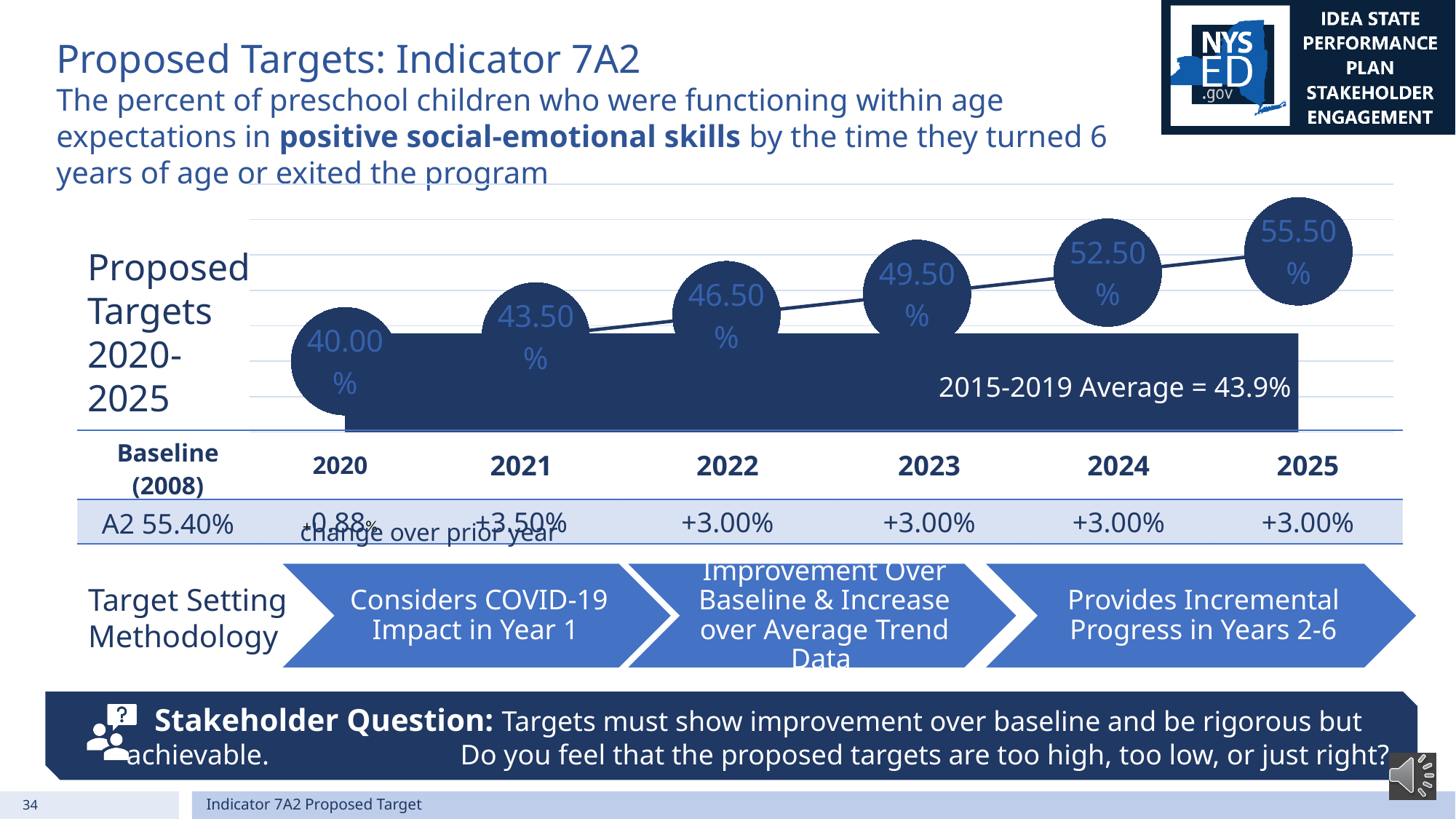
Which is larger, the proposed target for 2024 or for 2022? 2024 What is the difference between the proposed targets for 2022 and 2021? 3.00% What is the proposed target value for 2020? 40.00% Which year has the lowest proposed target? 2020 Do the proposed target values rise or fall from 2020 to 2025? Rise What kind of chart is used to show the proposed targets? Line chart What is the proposed target value for 2023? 49.50% Which year has the highest proposed target? 2025 What is the proposed target value for 2025? 55.50% What is the difference between the proposed targets for 2025 and 2020? 15.50% What 2015-2019 average is shown on the chart? 43.9% How many years are plotted in the proposed targets chart? 6